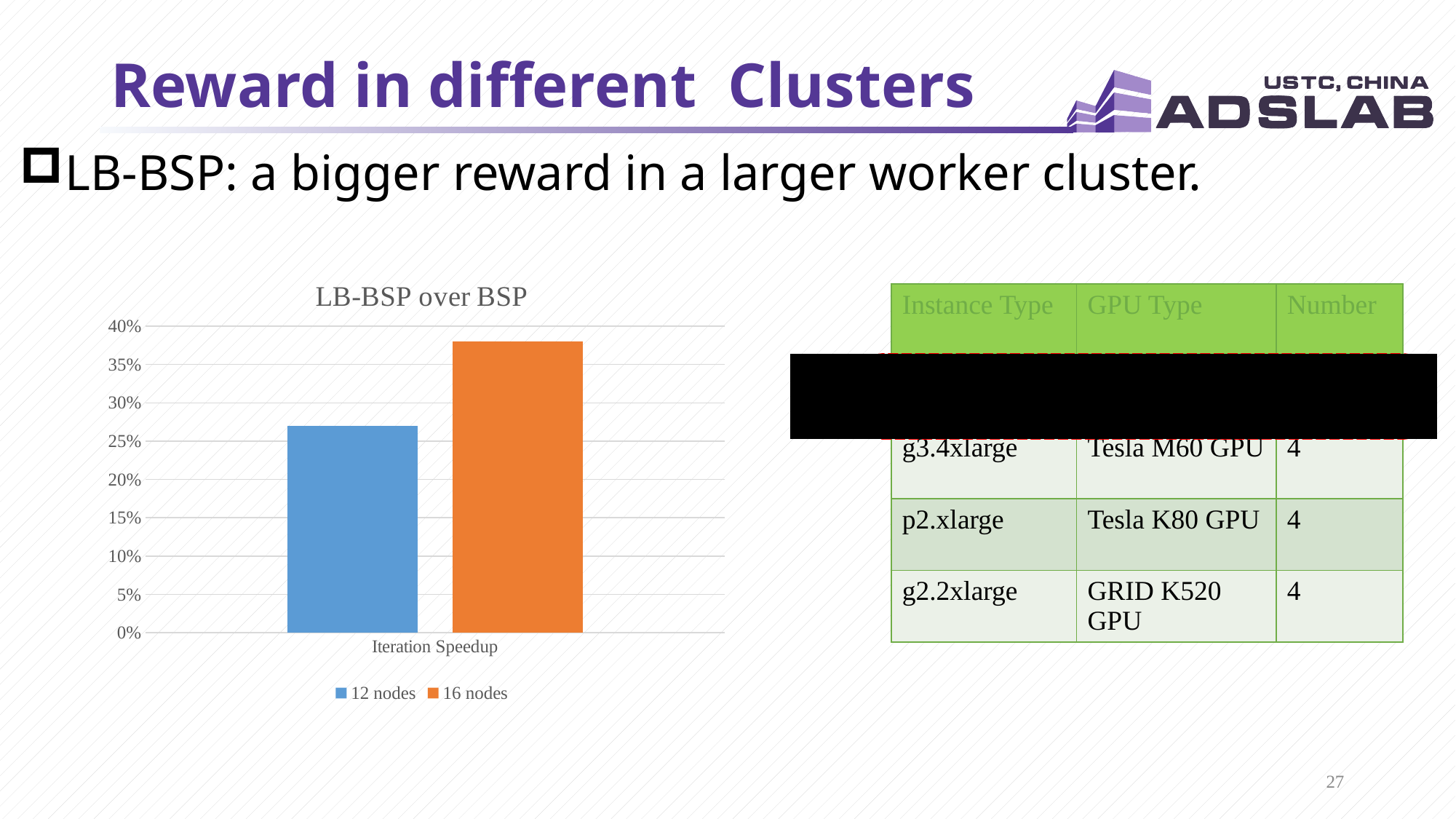
Which series shows the lowest Iteration Speedup in the chart? 12 nodes How many series does the chart's legend list? 2 Is the Iteration Speedup for 16 nodes greater or less than 35%? greater Is the Iteration Speedup for 12 nodes greater or less than 25%? greater What kind of chart is shown on the slide? bar chart Is the Iteration Speedup for 16 nodes greater or less than 40%? less What is the title of the chart? LB-BSP over BSP What are the two series named in the chart's legend? 12 nodes and 16 nodes How many categories are shown on the x axis of the chart? 1 Which series has the higher Iteration Speedup in the chart, 12 nodes or 16 nodes? 16 nodes Which series shows the highest Iteration Speedup in the chart? 16 nodes